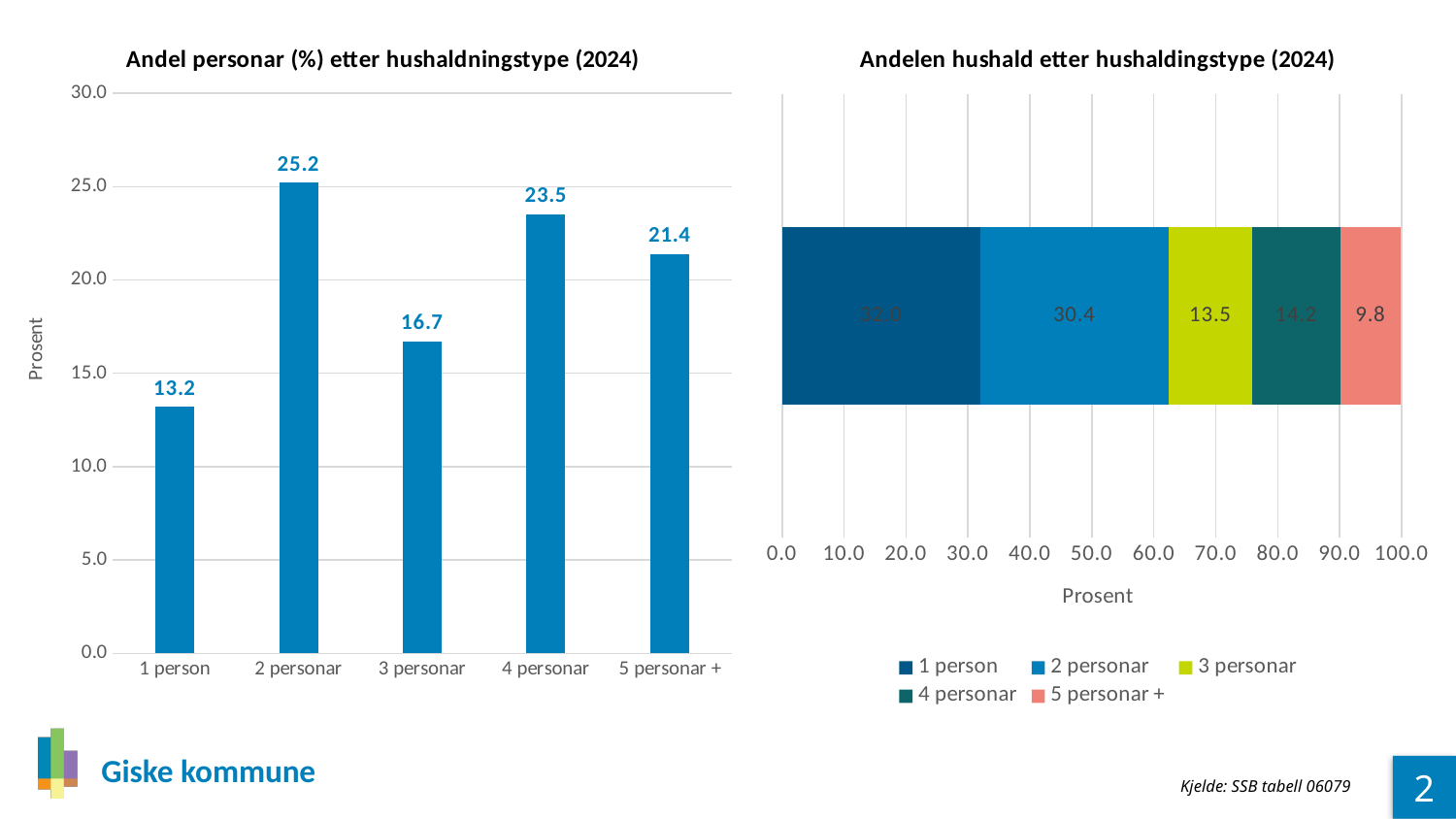
In the chart 'Andel personar (%) etter hushaldningstype (2024)', what is the difference between the values for 4 personar and 3 personar? 6.8 In the chart 'Andelen hushald etter hushaldingstype (2024)', what is the value for 2 personar? 30.4 In the chart 'Andel personar (%) etter hushaldningstype (2024)', which household type has the highest value? 2 personar In the chart 'Andel personar (%) etter hushaldningstype (2024)', what is the value for 2 personar? 25.2 In the chart 'Andel personar (%) etter hushaldningstype (2024)', which is larger: the value for 5 personar + or the value for 3 personar? 5 personar + How many series does the legend of the chart 'Andelen hushald etter hushaldingstype (2024)' list? 5 What is the x-axis label of the chart 'Andelen hushald etter hushaldingstype (2024)'? Prosent In the chart 'Andel personar (%) etter hushaldningstype (2024)', which household type has the lowest value? 1 person What kind of chart is 'Andel personar (%) etter hushaldningstype (2024)'? Bar chart How many household categories are shown in the chart 'Andel personar (%) etter hushaldningstype (2024)'? 5 In the chart 'Andel personar (%) etter hushaldningstype (2024)', what is the value for 1 person? 13.2 In the chart 'Andelen hushald etter hushaldingstype (2024)', what is the value for 5 personar +? 9.8